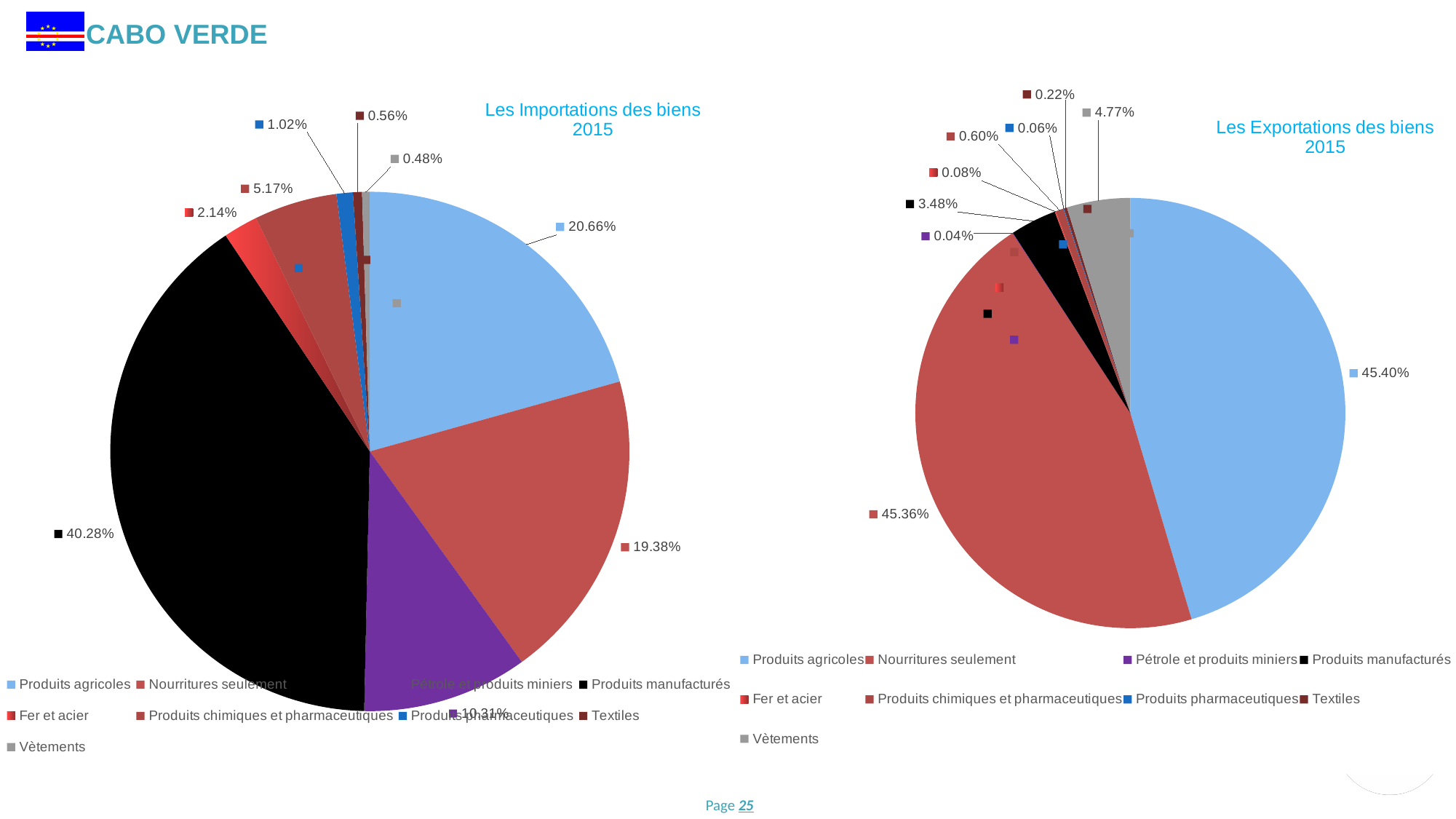
What type of chart is used for 'Les Importations des biens 2015'? Pie chart In the 'Les Importations des biens 2015' pie chart, what is the difference between the shares of Produits agricoles and Nourritures seulement? 1.28% In the 'Les Importations des biens 2015' pie chart, what share is shown for Produits agricoles? 20.66% In the 'Les Exportations des biens 2015' pie chart, what share is shown for Vètements? 4.77% In the 'Les Importations des biens 2015' pie chart, which category has the smallest slice? Vètements In the 'Les Exportations des biens 2015' pie chart, what share is shown for Produits manufacturés? 3.48% In the 'Les Exportations des biens 2015' pie chart, which category has the smallest share? Pétrole et produits miniers In the 'Les Importations des biens 2015' pie chart, what share is shown for Produits manufacturés? 40.28% In the 'Les Importations des biens 2015' pie chart, which is larger: Pétrole et produits miniers or Produits chimiques et pharmaceutiques? Pétrole et produits miniers In the 'Les Importations des biens 2015' pie chart, which category has the largest slice? Produits manufacturés In the 'Les Exportations des biens 2015' pie chart, which is larger: Vètements or Produits manufacturés? Vètements How many categories does the legend of the 'Les Exportations des biens 2015' chart list? 9